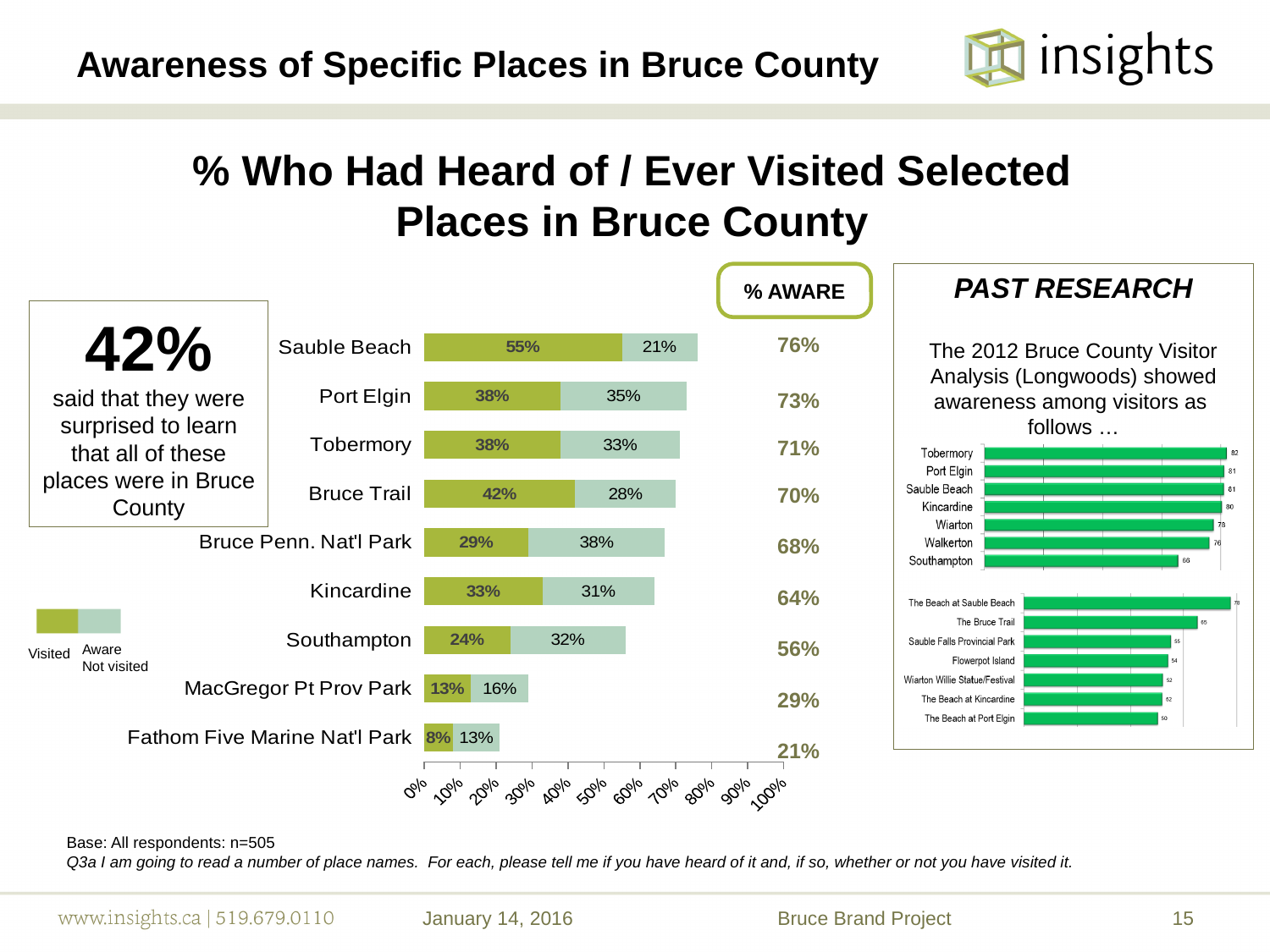
In the main chart, which place has the lowest 'Visited' percentage? Fathom Five Marine Nat'l Park What type of chart is the main chart on the slide? Stacked bar chart How many places are shown in the main stacked bar chart? 9 In the main chart, what is the % AWARE figure for Bruce Trail? 70% In the main chart, which place has the highest % AWARE? Sauble Beach In the 'PAST RESEARCH' box, which place has the highest awareness value in the upper chart? Tobermory In the main chart, which is larger: the 'Visited' value for Kincardine or the 'Visited' value for Southampton? Kincardine In the main chart, what is the difference between the 'Visited' percentages for Sauble Beach and Bruce Trail? 13% In the main chart, what is the 'Aware Not visited' value for Port Elgin? 35% How many series does the legend of the main chart list? 2 In the main chart '% Who Had Heard of / Ever Visited Selected Places in Bruce County', what percentage of respondents had visited Sauble Beach? 55% In the main chart, what is the total (% AWARE) of the stacked bar for MacGregor Pt Prov Park? 29%